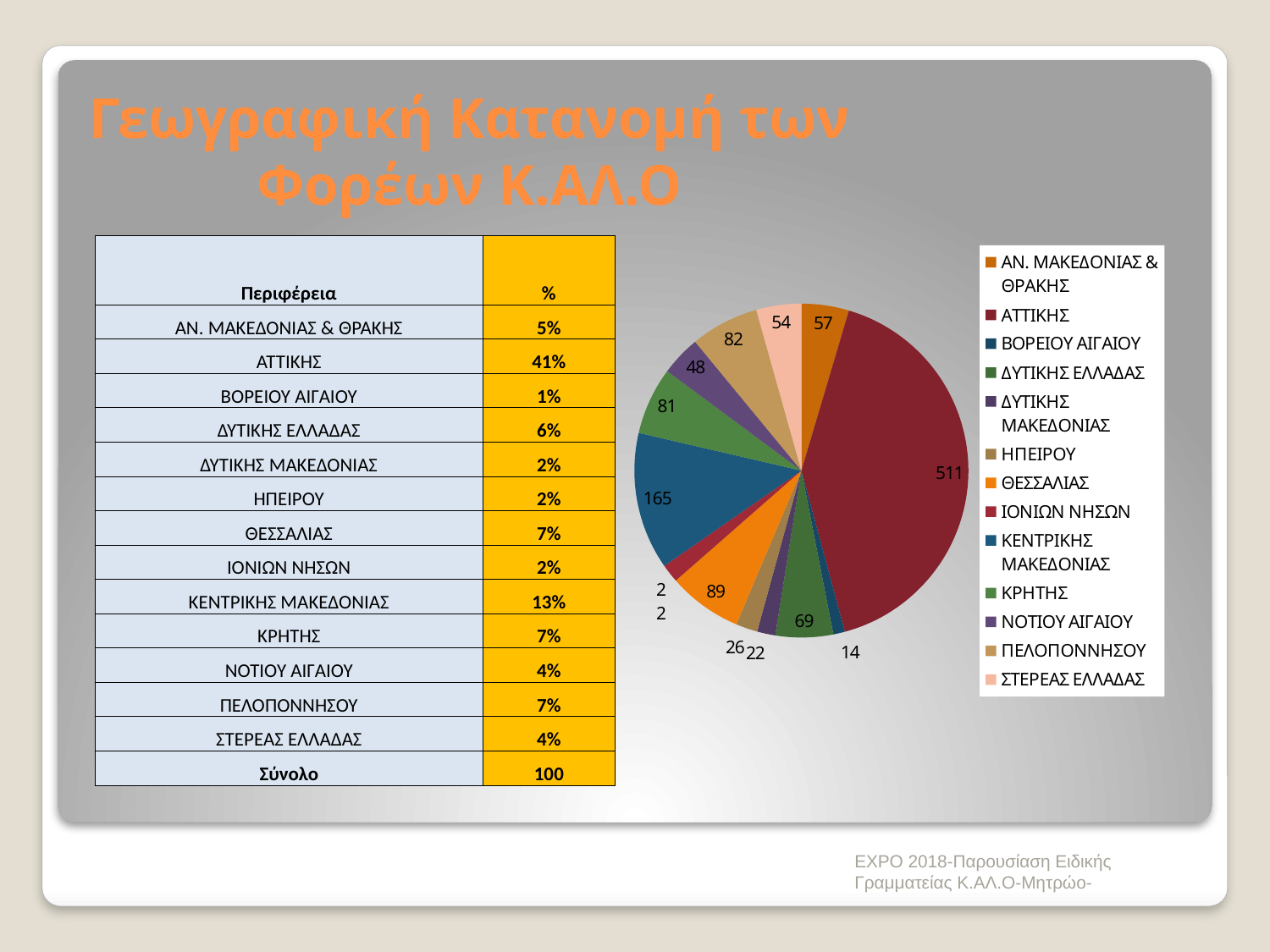
What is the difference between the values for ΠΕΛΟΠΟΝΝΗΣΟΥ and ΚΡΗΤΗΣ in the pie chart? 1 What value is shown for ΘΕΣΣΑΛΙΑΣ in the pie chart? 89 What kind of chart is shown on the slide? Pie chart What value is shown for ΒΟΡΕΙΟΥ ΑΙΓΑΙΟΥ in the pie chart? 14 Which has the larger value in the pie chart, ΘΕΣΣΑΛΙΑΣ or ΔΥΤΙΚΗΣ ΕΛΛΑΔΑΣ? ΘΕΣΣΑΛΙΑΣ What value is shown for ΚΕΝΤΡΙΚΗΣ ΜΑΚΕΔΟΝΙΑΣ in the pie chart? 165 Which has the larger value in the pie chart, ΚΡΗΤΗΣ or ΝΟΤΙΟΥ ΑΙΓΑΙΟΥ? ΚΡΗΤΗΣ How many regions are listed in the pie chart's legend? 13 Which region has the largest slice in the pie chart? ΑΤΤΙΚΗΣ What value is shown for ΑΤΤΙΚΗΣ in the pie chart? 511 What is the difference between the values for ΑΤΤΙΚΗΣ and ΚΕΝΤΡΙΚΗΣ ΜΑΚΕΔΟΝΙΑΣ in the pie chart? 346 What value is shown for ΣΤΕΡΕΑΣ ΕΛΛΑΔΑΣ in the pie chart? 54